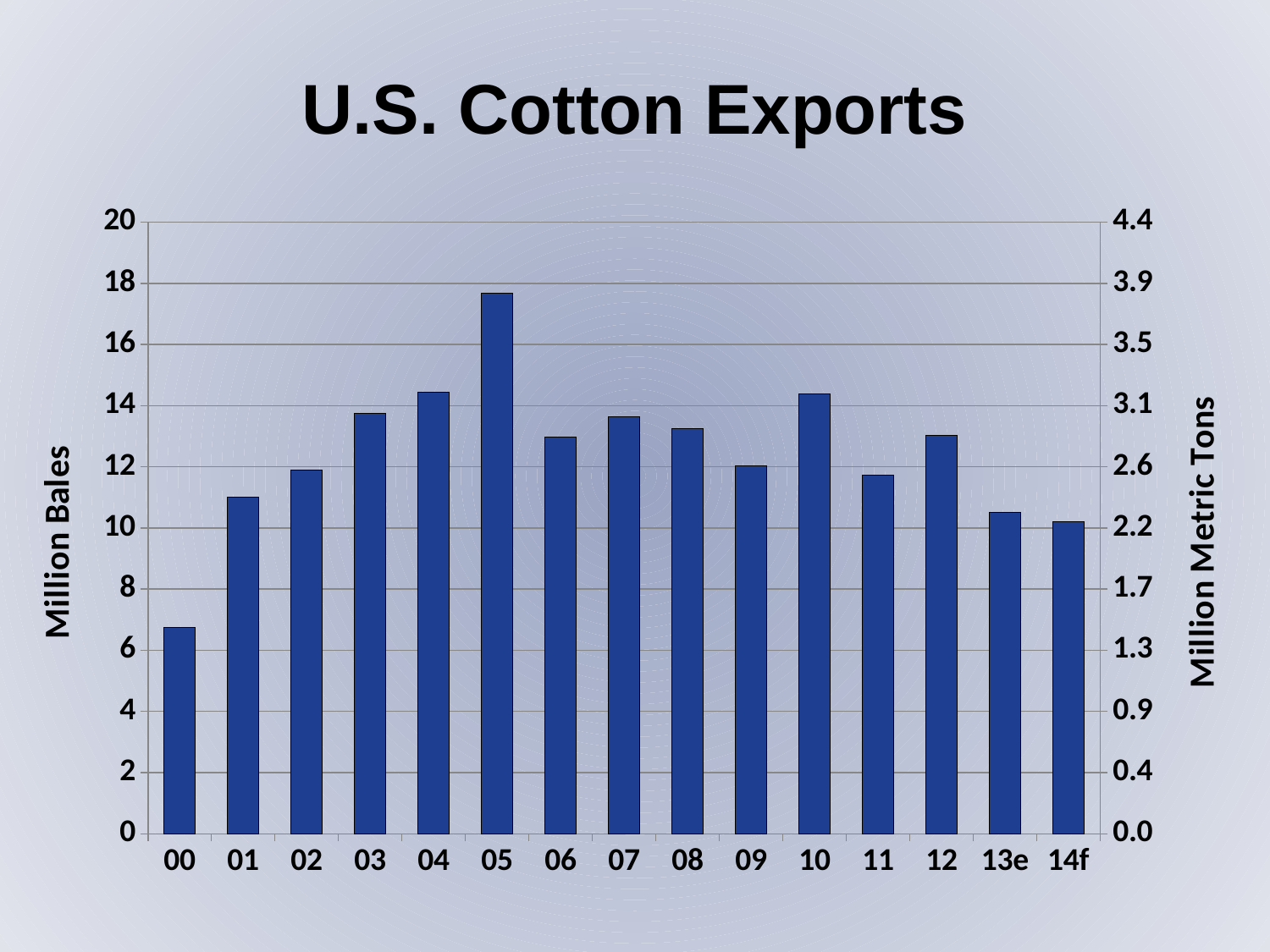
Do the values rise or fall from 00 to 05? rise Is the value for 06 greater or less than 14 million bales? less Which year has the lowest cotton exports? 00 Is the value for 05 greater or less than 16 million bales? greater What is the label of the left vertical axis? Million Bales What type of chart is shown on the slide? bar chart What is the title of the chart? U.S. Cotton Exports Which is larger, the value for 04 or the value for 05? 05 How many years (categories) are shown on the x axis? 15 Is the value for 09 greater or less than 10 million bales? greater Which year has the highest cotton exports? 05